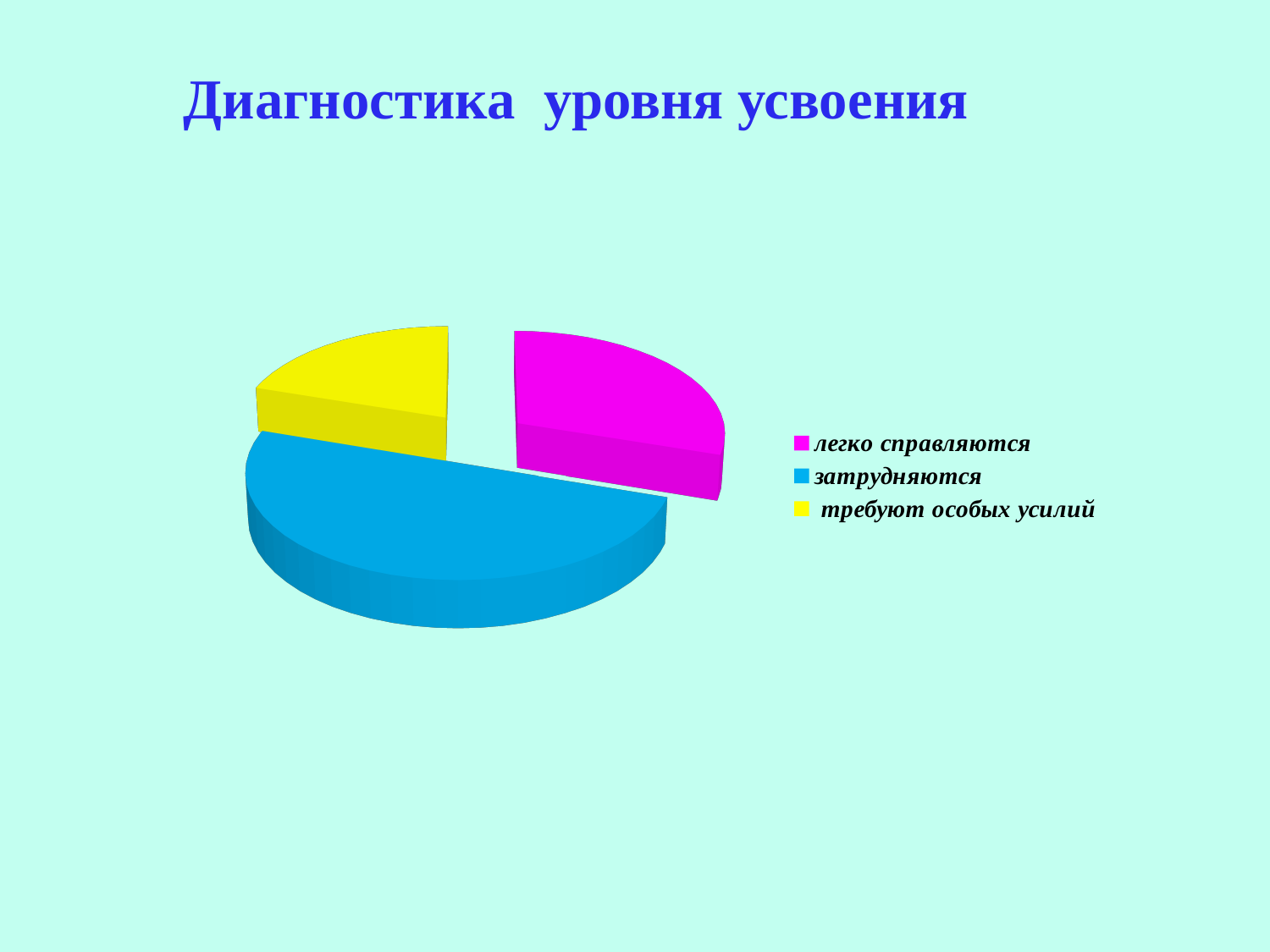
What colour is the slice for "легко справляются" in the pie chart? magenta How many slices does the pie chart have? 3 Which category has the largest slice in the pie chart? затрудняются Which slice is larger: "затрудняются" or "легко справляются"? затрудняются What is the title of the slide containing the pie chart? Диагностика уровня усвоения What kind of chart is shown on the slide? pie chart Which slice is larger: "затрудняются" or "требуют особых усилий"? затрудняются How many entries does the legend of the pie chart list? 3